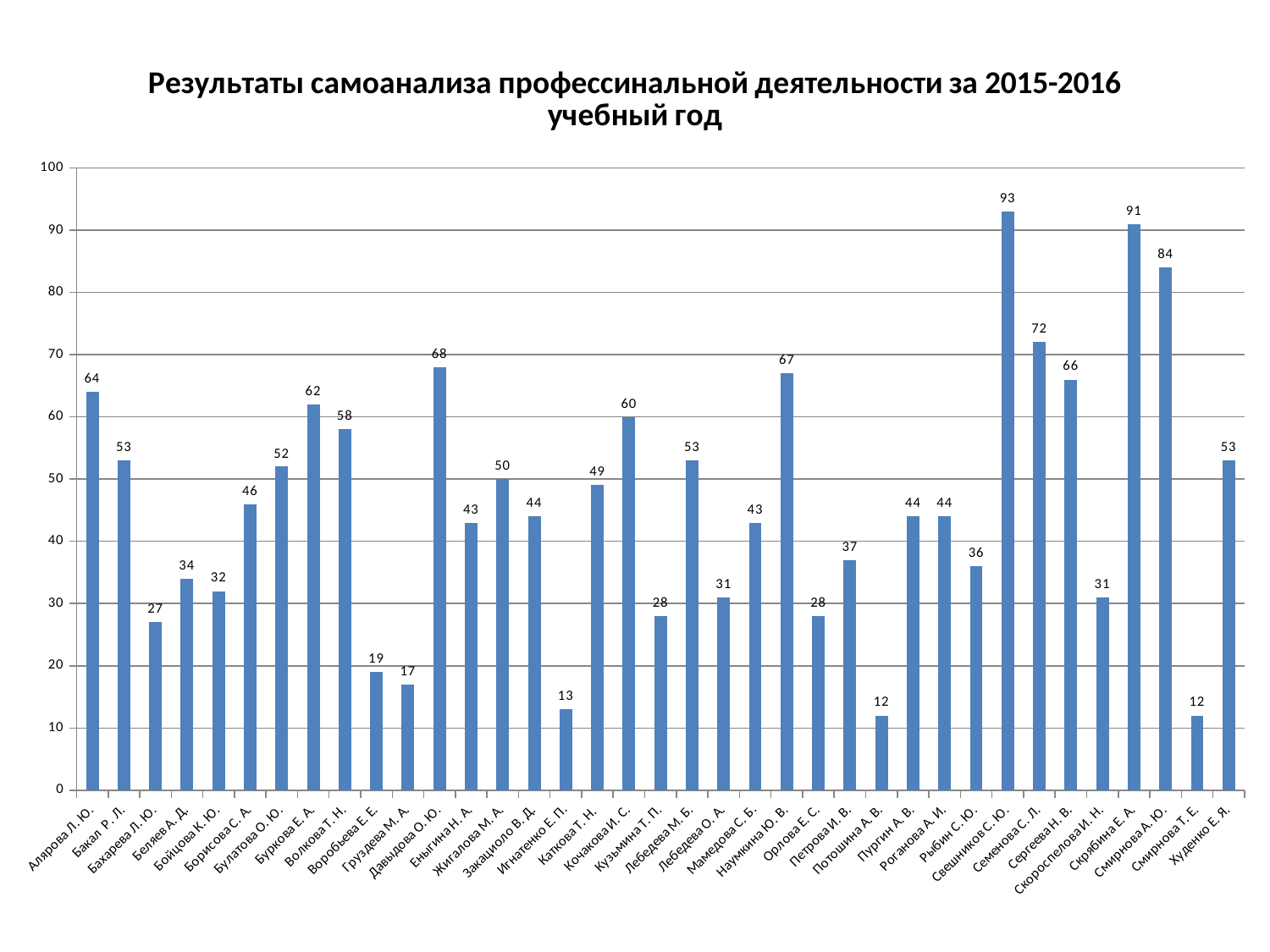
Is the value for Буркова Е. А. greater or less than 50? greater Which is larger, the value for Наумкина Ю. В. or the value for Кочакова И. С.? Наумкина Ю. В. What is the value for Давыдова О. Ю.? 68 What type of chart is shown on the slide? bar chart What is the lowest value shown in the chart? 12 Which person has the highest value in the chart? Свешников С. Ю. What is the title of the chart? Результаты самоанализа профессинальной деятельности за 2015-2016 учебный год What is the difference between the values for Скрябина Е. А. and Семенова С. Л.? 19 What is the value for Игнатенко Е. П.? 13 What is the value for Смирнова А. Ю.? 84 What is the value for Свешников С. Ю.? 93 How many people (categories) are shown in the chart? 37